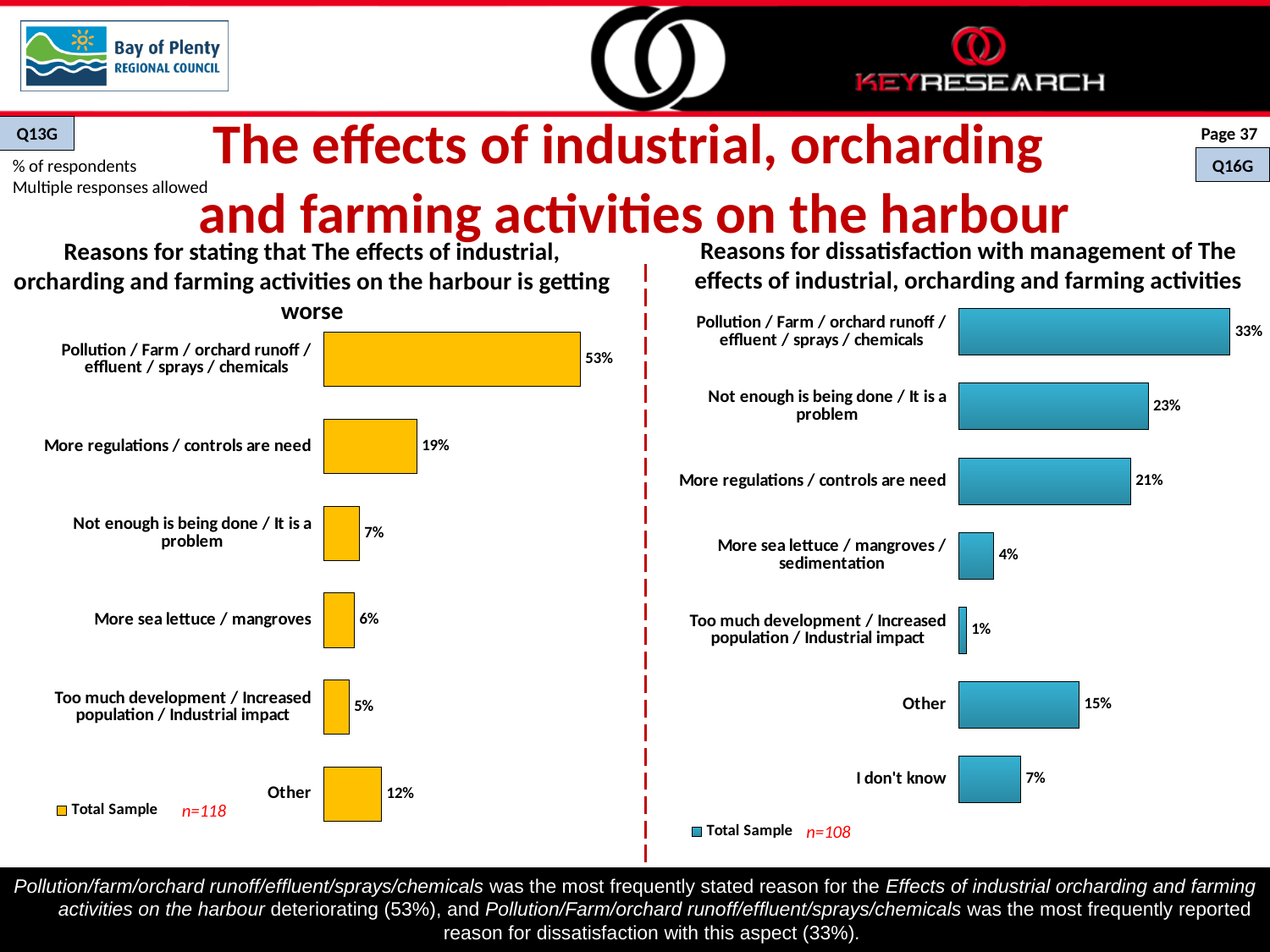
In the right chart (reasons for dissatisfaction with management), what is the difference between 'Pollution / Farm / orchard runoff / effluent / sprays / chemicals' and 'More regulations / controls are need'? 12% In the left chart (reasons for stating the effects are getting worse), how many categories are plotted? 6 In the right chart (reasons for dissatisfaction with management), which category has the lowest value? Too much development / Increased population / Industrial impact What is the sample size (n) shown for the right chart (reasons for dissatisfaction with management)? n=108 In the right chart (reasons for dissatisfaction with management), what percentage is shown for 'Not enough is being done / It is a problem'? 23% In the left chart (reasons for stating the effects are getting worse), which category has the lowest value? Too much development / Increased population / Industrial impact In the right chart (reasons for dissatisfaction with management), how many categories are plotted? 7 What type of chart is used on the left side of the slide? Bar chart In the left chart (reasons for stating the effects are getting worse), which category has the highest value? Pollution / Farm / orchard runoff / effluent / sprays / chemicals In the left chart (reasons for stating the effects are getting worse), what is the difference between 'Pollution / Farm / orchard runoff / effluent / sprays / chemicals' and 'Other'? 41% In the right chart (reasons for dissatisfaction with management), which is larger: 'More regulations / controls are need' or 'Other'? More regulations / controls are need In the left chart (reasons for stating the effects are getting worse), what percentage is shown for 'More regulations / controls are need'? 19%